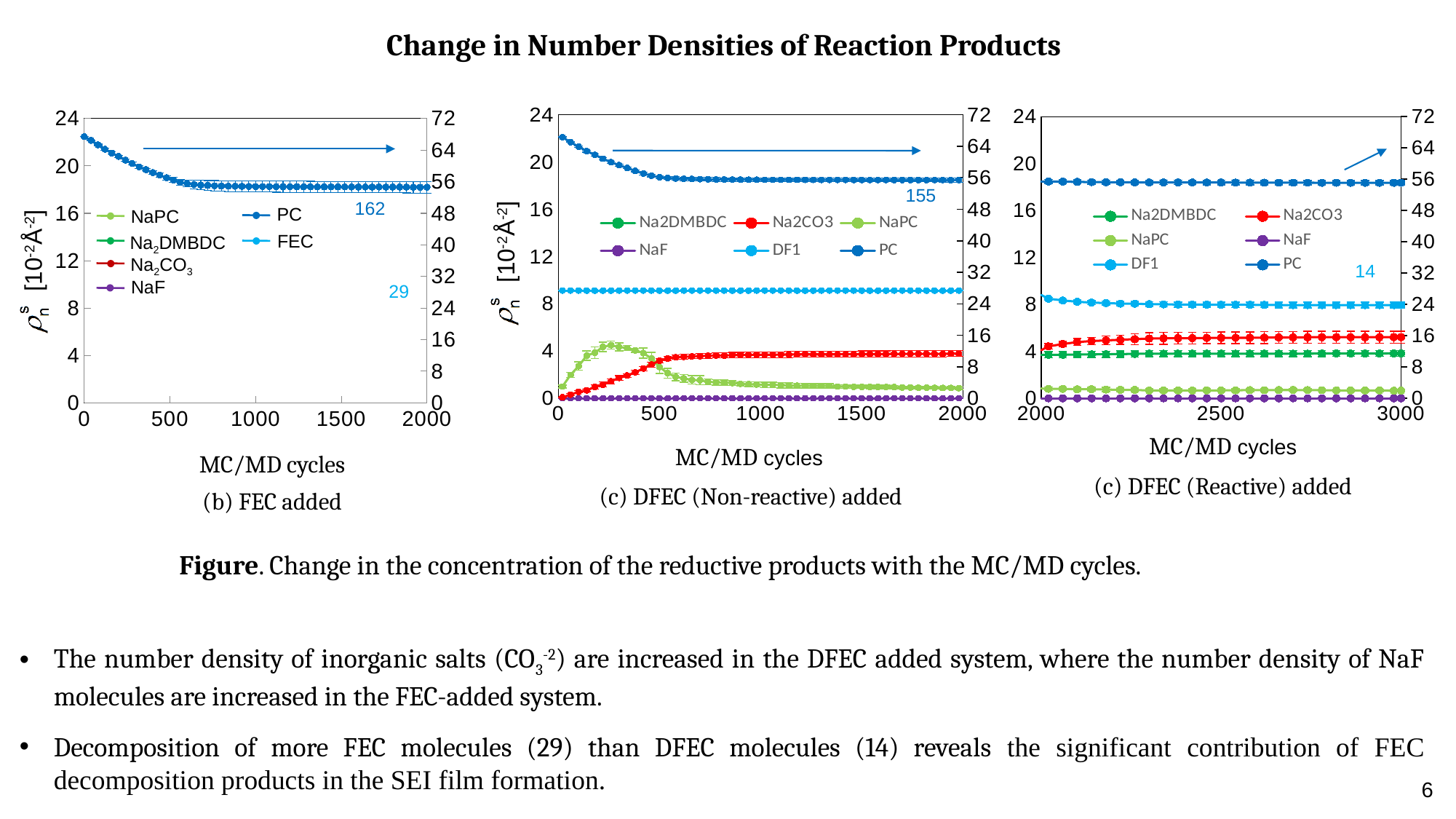
In the right chart "(c) DFEC (Reactive) added", is the value of NaF on the left axis greater or less than 4? less How many series does the legend of the middle chart "(c) DFEC (Non-reactive) added" list? 6 What is the x-axis label of the right chart "(c) DFEC (Reactive) added"? MC/MD cycles In the right chart "(c) DFEC (Reactive) added", at 3000 MC/MD cycles, which is larger: Na2CO3 or Na2DMBDC? Na2CO3 In the middle chart "(c) DFEC (Non-reactive) added", does the Na2CO3 series rise or fall between 0 and 1000 MC/MD cycles? rise In the middle chart "(c) DFEC (Non-reactive) added", at 2000 MC/MD cycles, which is larger: Na2CO3 or NaPC? Na2CO3 What kind of chart is the left chart, labelled "(b) FEC added"? line chart What number is annotated in blue next to the PC series in the middle chart "(c) DFEC (Non-reactive) added"? 155 In the middle chart "(c) DFEC (Non-reactive) added", is the value of DF1 on the left axis greater or less than 8? greater In the left chart "(b) FEC added", does the PC series rise or fall over the first 500 MC/MD cycles? fall How many series does the legend of the left chart "(b) FEC added" list? 6